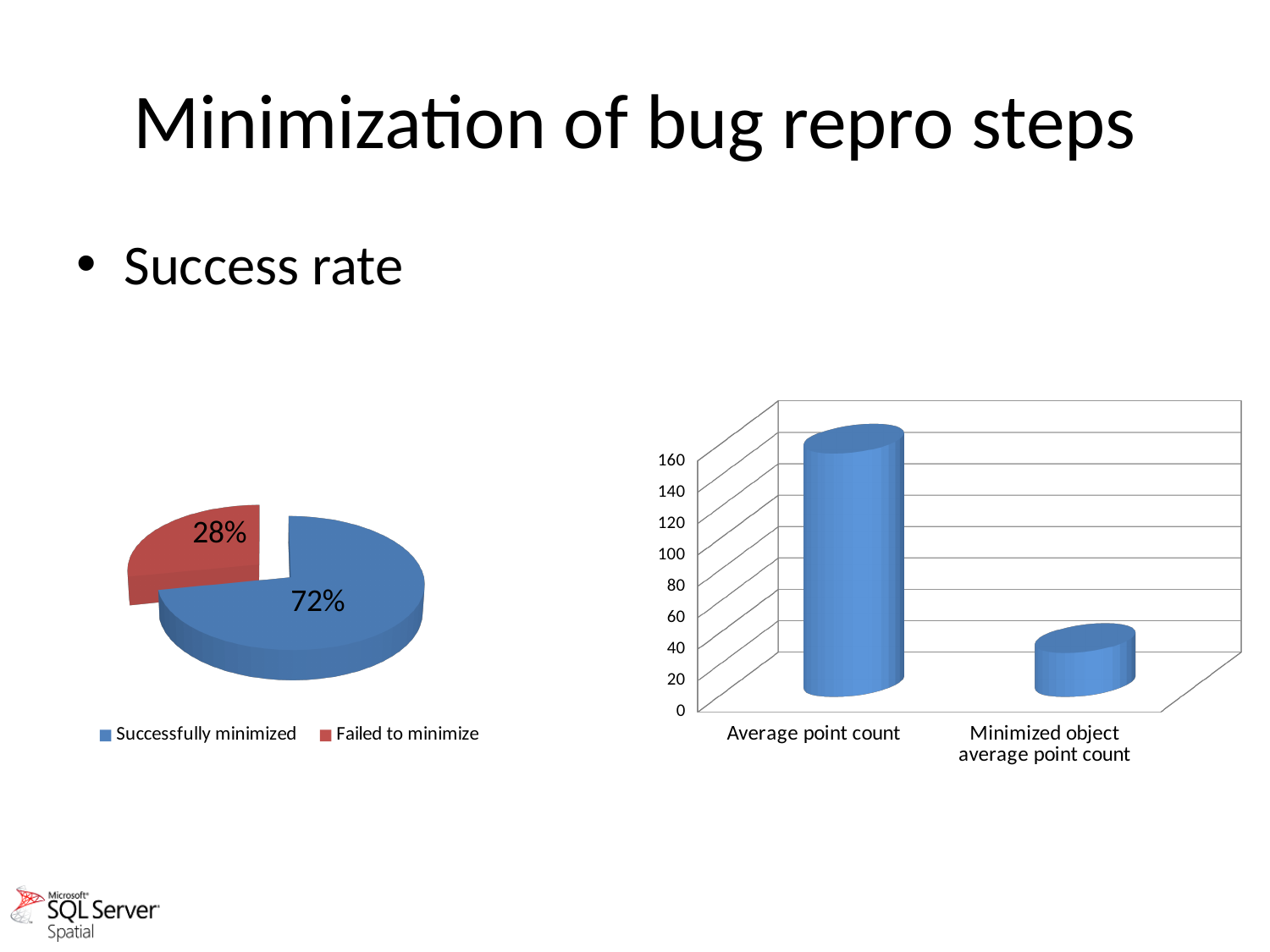
In the bar chart on the right, which category has the highest value? Average point count What kind of chart is the chart on the left of the slide? Pie chart In the bar chart on the right, is the value for Minimized object average point count greater or less than 60? less How many entries does the legend of the pie chart on the left list? 2 How many categories does the bar chart on the right show? 2 In the pie chart on the left, what colour is the Failed to minimize slice? Red How many slices does the pie chart on the left have? 2 In the pie chart on the left, what share of the pie is labelled Successfully minimized? 72% In the pie chart on the left, what share of the pie is labelled Failed to minimize? 28% In the pie chart on the left, what is the difference between the Successfully minimized share and the Failed to minimize share? 44% In the pie chart on the left, which slice is larger, Successfully minimized or Failed to minimize? Successfully minimized What kind of chart is the chart on the right of the slide? Bar chart